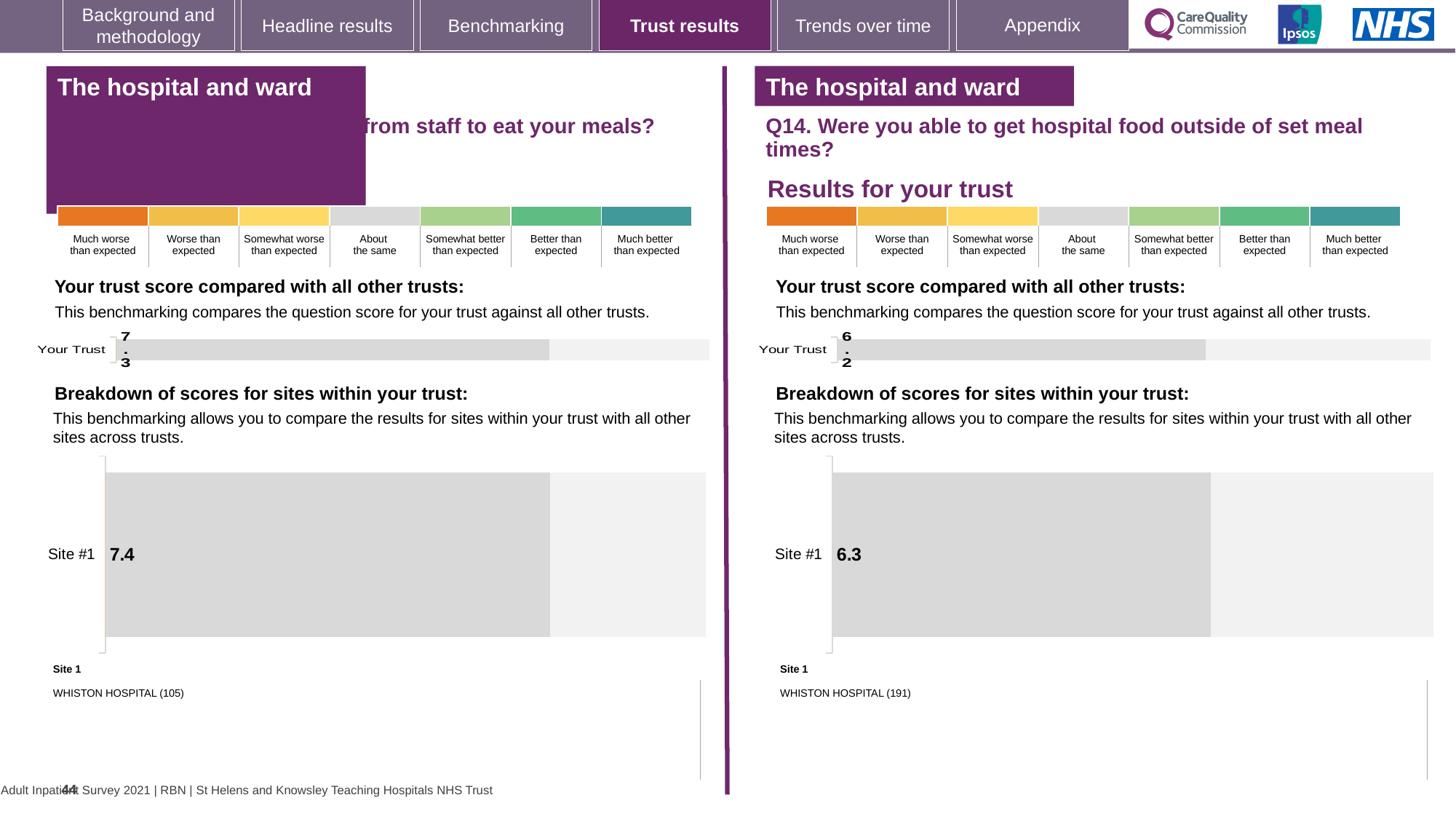
On the right half of the slide (Q14), what is the value shown for Your Trust in the trust score chart? 6.2 What is the difference between the Site #1 score on the left half of the slide (7.4) and the Site #1 score on the right half (6.3)? 1.1 What is the difference between the Your Trust score on the left half of the slide (7.3) and the Your Trust score on the right half (6.2)? 1.1 Which is larger: the Site #1 score on the left half of the slide or the Site #1 score on the right half (Q14)? Left half (7.4) On the left half of the slide, what score is shown for Site #1 in the breakdown of scores for sites chart? 7.4 On the left half of the slide, what is the value shown for Your Trust in the trust score chart? 7.3 On the right half of the slide (Q14), which is larger: the Your Trust score or the Site #1 score? Site #1 (6.3) Which hospital is listed as Site 1 on the right half of the slide, and how many respondents are shown in brackets? WHISTON HOSPITAL (191) What kind of chart is used to show the Site #1 score on the right half of the slide? Bar chart What is the question number and text shown above the charts on the right half of the slide? Q14. Were you able to get hospital food outside of set meal times? How many sites are shown in the breakdown of scores chart on the left half of the slide? 1 On the right half of the slide (Q14), what score is shown for Site #1 in the breakdown of scores for sites chart? 6.3